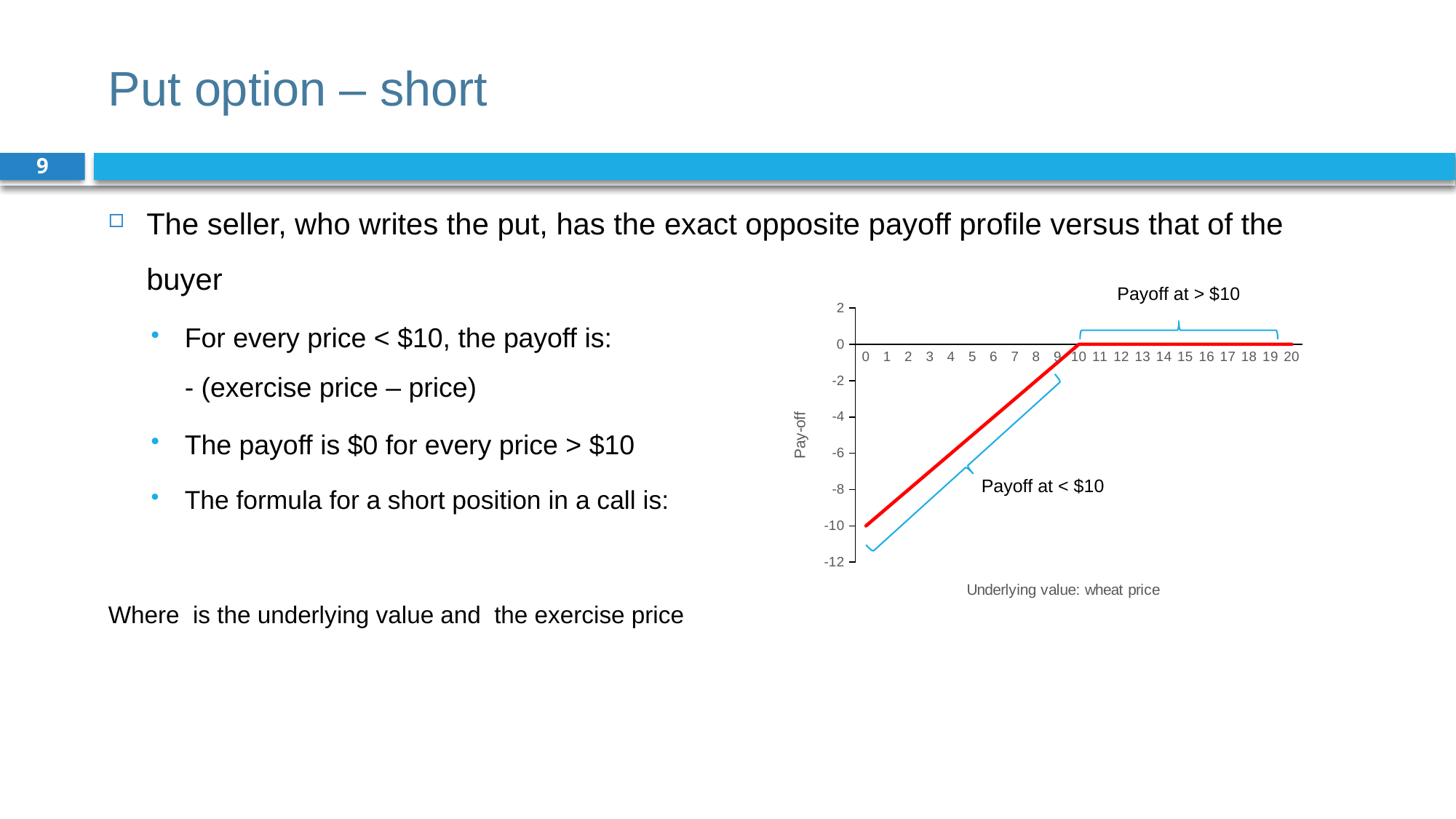
Which is larger, the pay-off at a wheat price of 3 or at a wheat price of 8? 8 Is the pay-off at a wheat price of 5 greater or less than -2? less What is the label of the x axis of the chart? Underlying value: wheat price At which wheat price is the pay-off lowest? 0 Does the pay-off rise or fall as the wheat price increases from 0 to 10? rises Is the pay-off at a wheat price of 2 greater or less than -4? less What is the pay-off when the wheat price is 0? -10 What is the label of the y axis of the chart? Pay-off What kind of chart is shown on the slide? line chart What is the pay-off when the wheat price is 10? 0 What is the pay-off when the wheat price is 20? 0 What is the pay-off when the wheat price is 8? -2